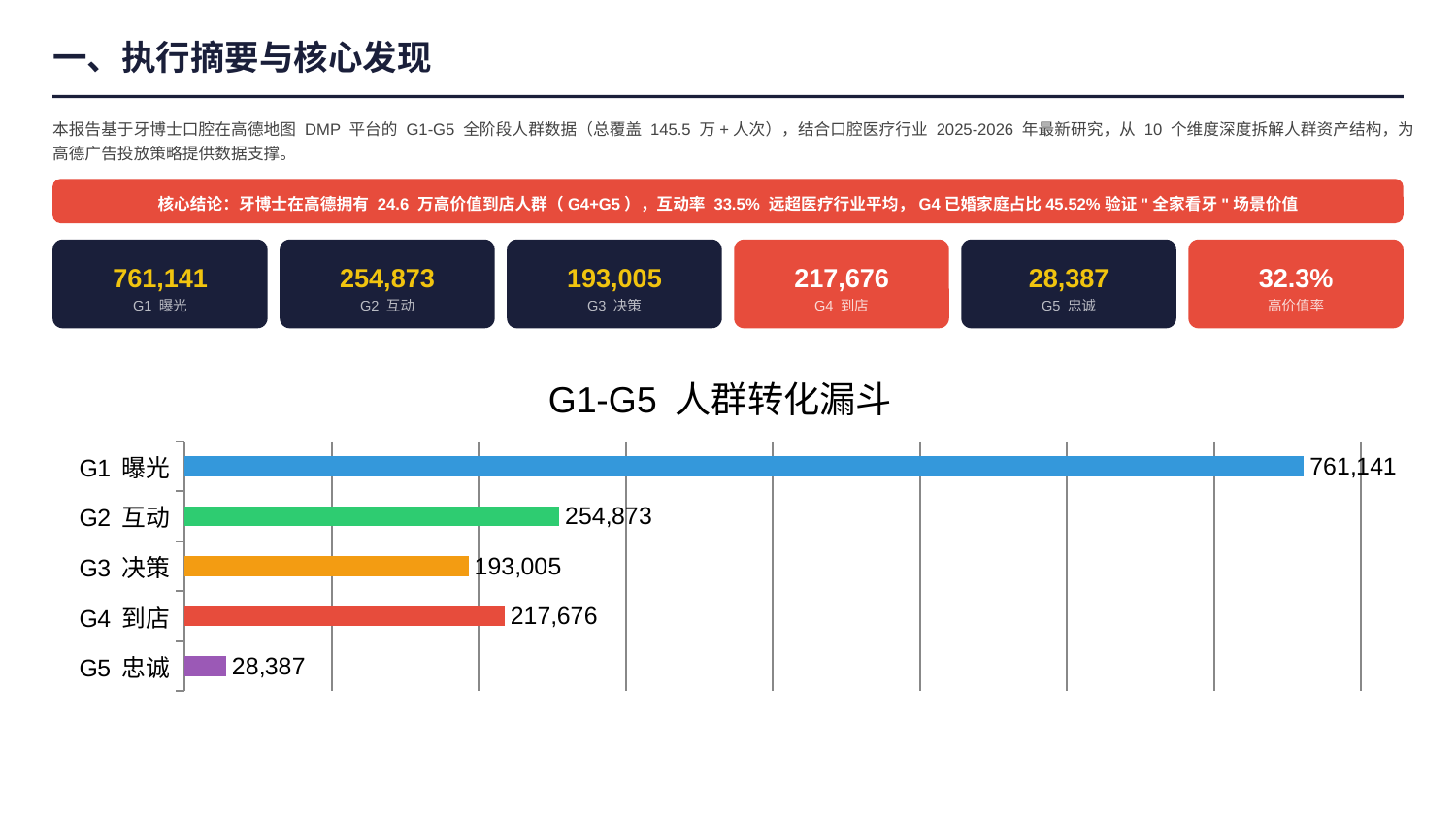
What is the value for G4 到店 in the G1-G5 人群转化漏斗 chart? 217,676 How many categories are shown in the G1-G5 人群转化漏斗 chart? 5 In the G1-G5 人群转化漏斗 chart, which is larger, G3 决策 or G4 到店? G4 到店 What is the difference between the values for G1 曝光 and G2 互动 in the G1-G5 人群转化漏斗 chart? 506,268 Which category has the lowest value in the G1-G5 人群转化漏斗 chart? G5 忠诚 What is the value for G3 决策 in the G1-G5 人群转化漏斗 chart? 193,005 What is the difference between the values for G4 到店 and G3 决策 in the G1-G5 人群转化漏斗 chart? 24,671 What kind of chart is the G1-G5 人群转化漏斗 chart? Bar chart What is the value for G5 忠诚 in the G1-G5 人群转化漏斗 chart? 28,387 What is the title of the chart on the slide? G1-G5 人群转化漏斗 Which category has the highest value in the G1-G5 人群转化漏斗 chart? G1 曝光 What is the value for G1 曝光 in the G1-G5 人群转化漏斗 chart? 761,141